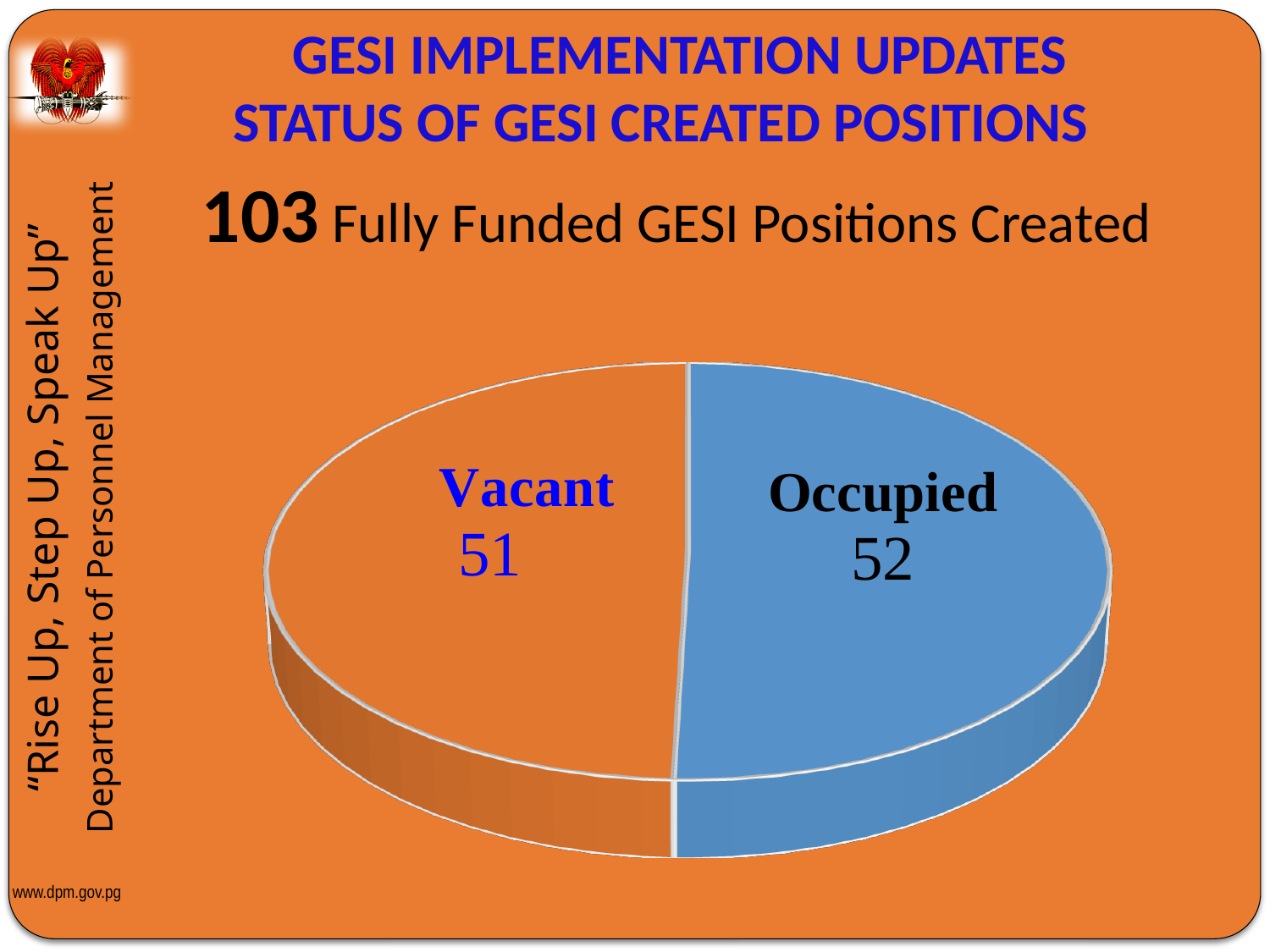
What kind of chart is shown on the slide? pie chart According to the text above the chart, how many fully funded GESI positions were created? 103 Which slice of the pie chart has the larger value? Occupied What colour is the Occupied slice of the pie chart? blue How many slices does the pie chart have? 2 Is the value for Occupied larger or smaller than the value for Vacant? larger What is the total of the two slices in the pie chart? 103 What is the difference between the Occupied and Vacant values in the pie chart? 1 Which slice of the pie chart has the smaller value? Vacant What is the value for the Occupied slice in the pie chart? 52 What is the value for the Vacant slice in the pie chart? 51